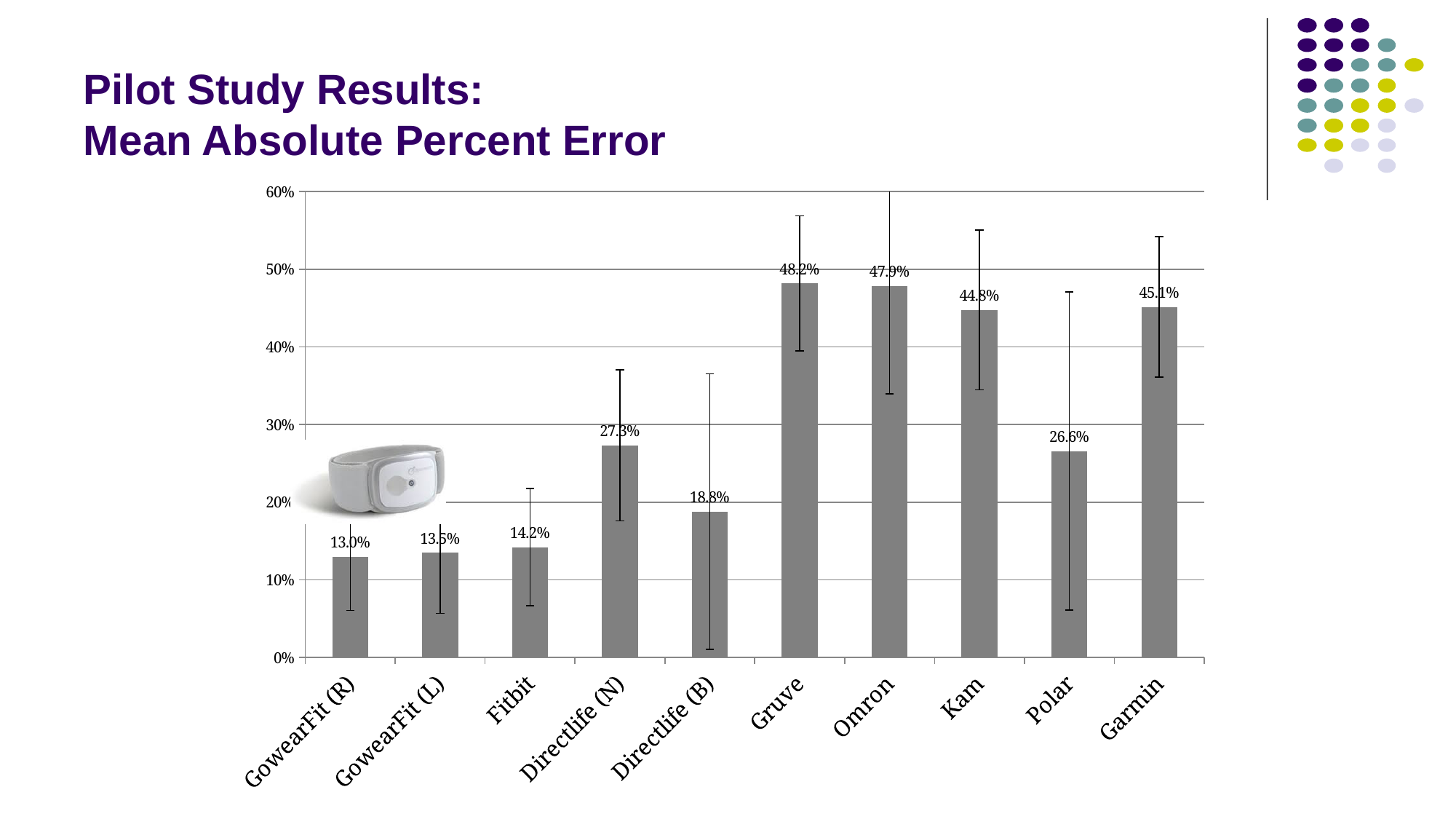
What is the value shown for Polar? 26.6% How many devices are shown on the x axis? 10 What is the mean absolute percent error for Gruve? 48.2% What kind of chart is shown on the slide? Bar chart Which device has the lowest mean absolute percent error? GowearFit (R) Which device has the highest mean absolute percent error? Gruve What is the difference between the values for Directlife (N) and Directlife (B)? 8.5% What is the difference between the values for Garmin and GowearFit (L)? 31.6% What is the mean absolute percent error for Fitbit? 14.2% Which has a larger mean absolute percent error, Kam or Polar? Kam What is the title of the slide containing the chart? Pilot Study Results: Mean Absolute Percent Error Is the value for Omron greater or less than 40%? greater